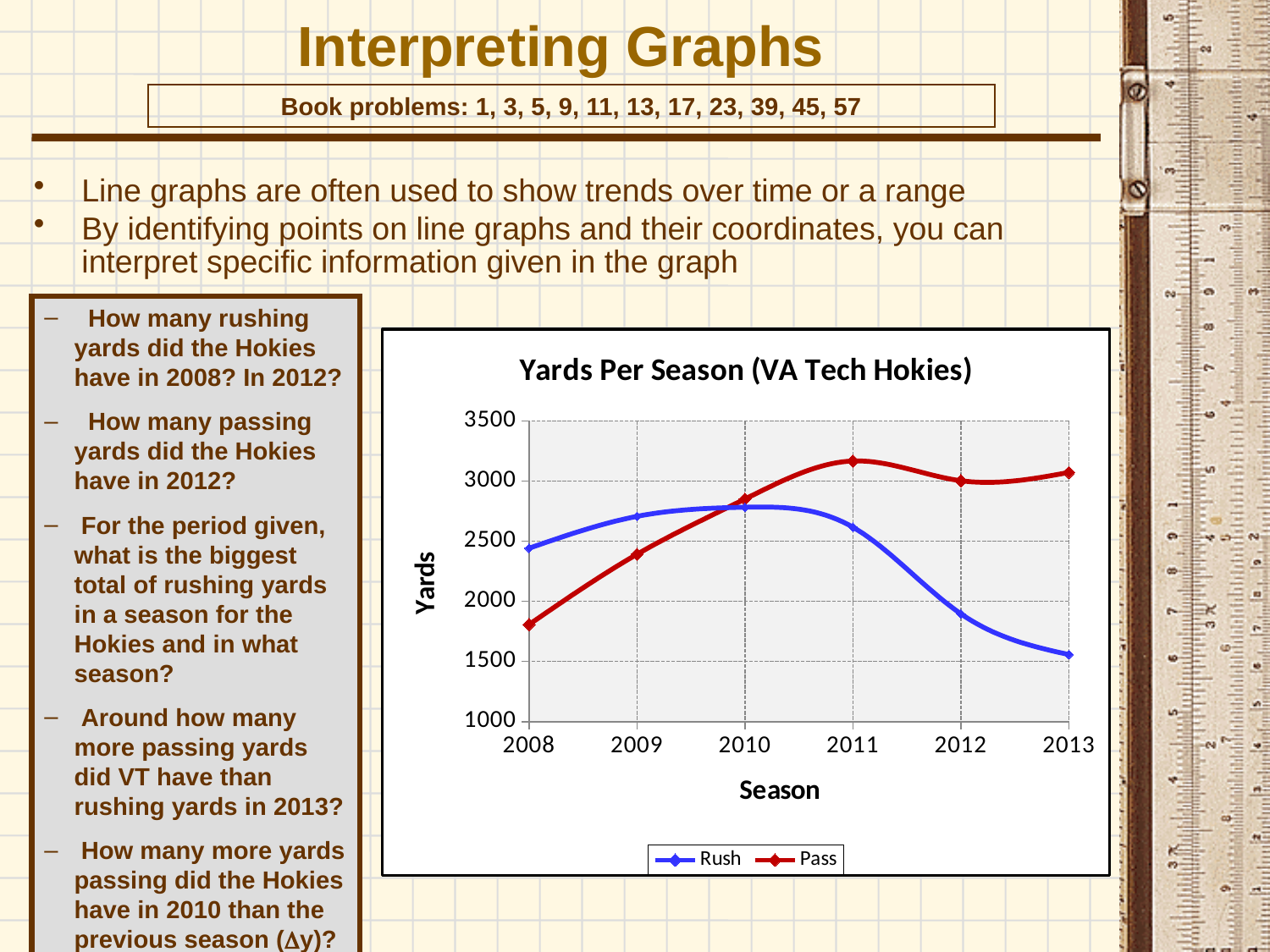
What is the title of the chart? Yards Per Season (VA Tech Hokies) In 2008, which series has the larger value, Rush or Pass? Rush How many seasons are plotted along the x axis? 6 In 2013, which series has the larger value, Rush or Pass? Pass Is the Rush value for 2009 greater or less than 2500? greater In which season is the Rush value lowest? 2013 What is the label of the y axis? Yards How many series does the legend list? 2 Is the Pass value for 2008 greater or less than 2000? less Is the Pass value for 2011 greater or less than 3000? greater What kind of chart is shown on the slide? line chart